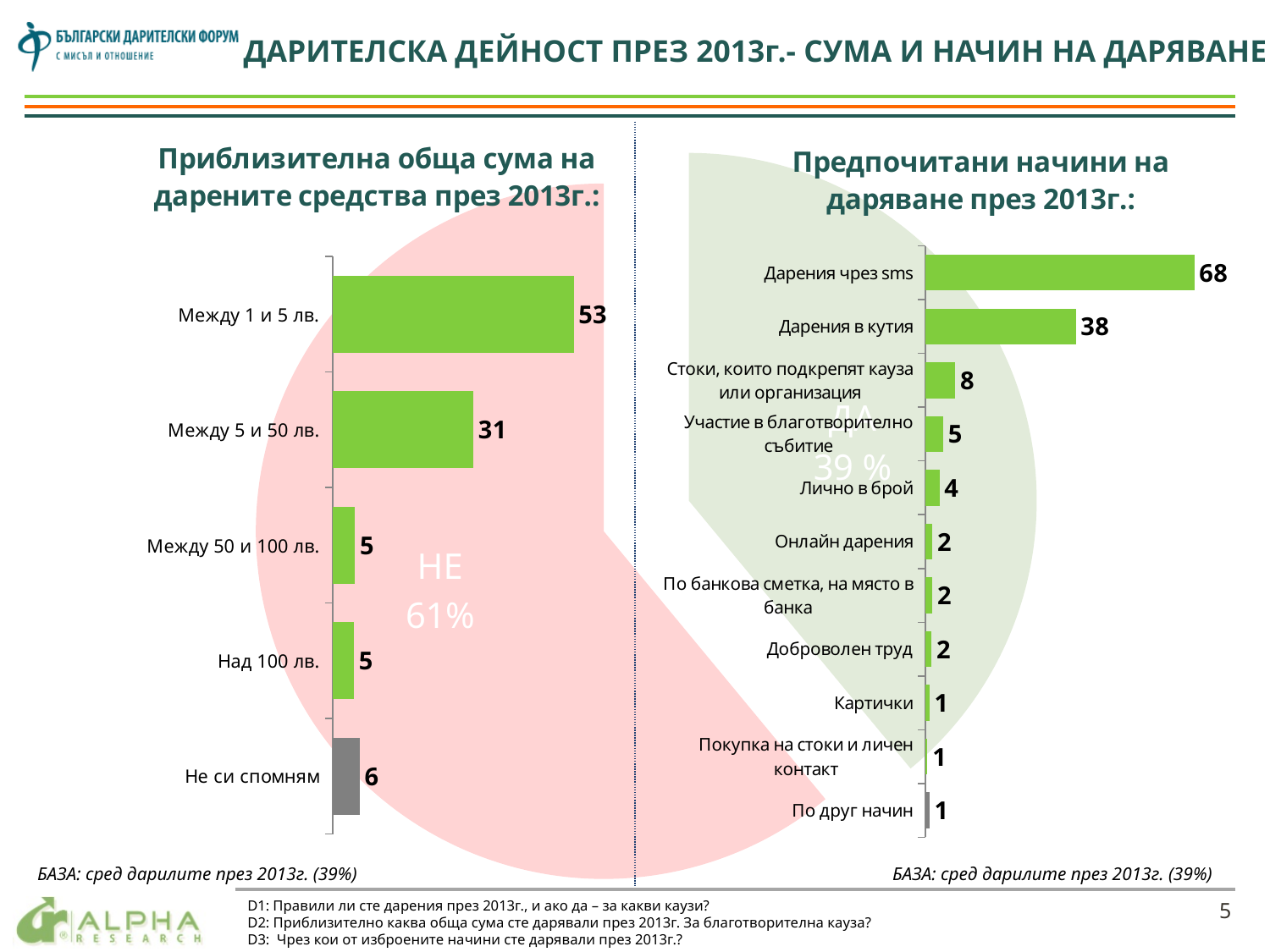
In the right chart (Предпочитани начини на даряване през 2013г.), how many categories are shown? 11 In the right chart (Предпочитани начини на даряване през 2013г.), which is larger: 'Стоки, които подкрепят кауза или организация' or 'Участие в благотворително събитие'? Стоки, които подкрепят кауза или организация In the left chart (Приблизителна обща сума на дарените средства през 2013г.), what is the value for 'Между 1 и 5 лв.'? 53 In the left chart (Приблизителна обща сума на дарените средства през 2013г.), what is the difference between 'Между 1 и 5 лв.' and 'Между 5 и 50 лв.'? 22 In the left chart (Приблизителна обща сума на дарените средства през 2013г.), which category has the highest value? Между 1 и 5 лв. In the right chart (Предпочитани начини на даряване през 2013г.), what is the value for 'Лично в брой'? 4 In the left chart (Приблизителна обща сума на дарените средства през 2013г.), how many categories are shown? 5 In the right chart (Предпочитани начини на даряване през 2013г.), what is the value for 'Дарения чрез sms'? 68 In the right chart (Предпочитани начини на даряване през 2013г.), which category has the highest value? Дарения чрез sms In the left chart (Приблизителна обща сума на дарените средства през 2013г.), what is the value for 'Не си спомням'? 6 In the right chart (Предпочитани начини на даряване през 2013г.), what is the value for 'Дарения в кутия'? 38 What type of chart is the right chart (Предпочитани начини на даряване през 2013г.)? Bar chart